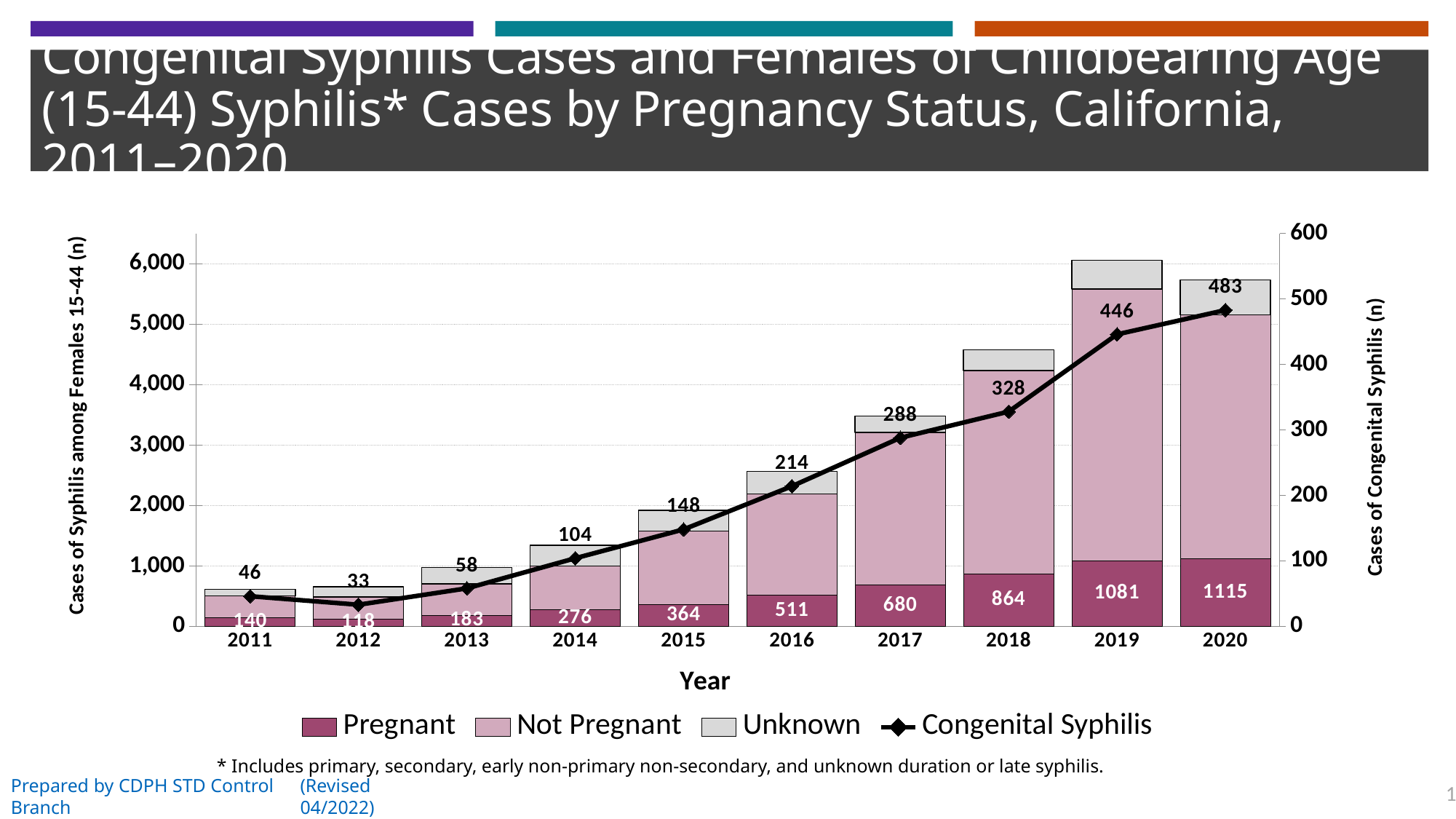
Which year has the lowest Congenital Syphilis value? 2012 How many series does the legend list? 4 What is the Pregnant value for 2017? 680 What is the difference between the Pregnant values for 2020 and 2019? 34 Does the Congenital Syphilis line generally rise or fall from 2012 to 2020? rise How many years are shown on the x axis? 10 Which is larger, the Pregnant value for 2015 or for 2016? 2016 Is the total stacked bar for 2019 greater or less than 5,000 on the left axis? greater Which year has the highest Pregnant value? 2020 What is the Congenital Syphilis value for 2014? 104 What is the Congenital Syphilis value for 2020? 483 What is the difference between the Congenital Syphilis values for 2019 and 2018? 118